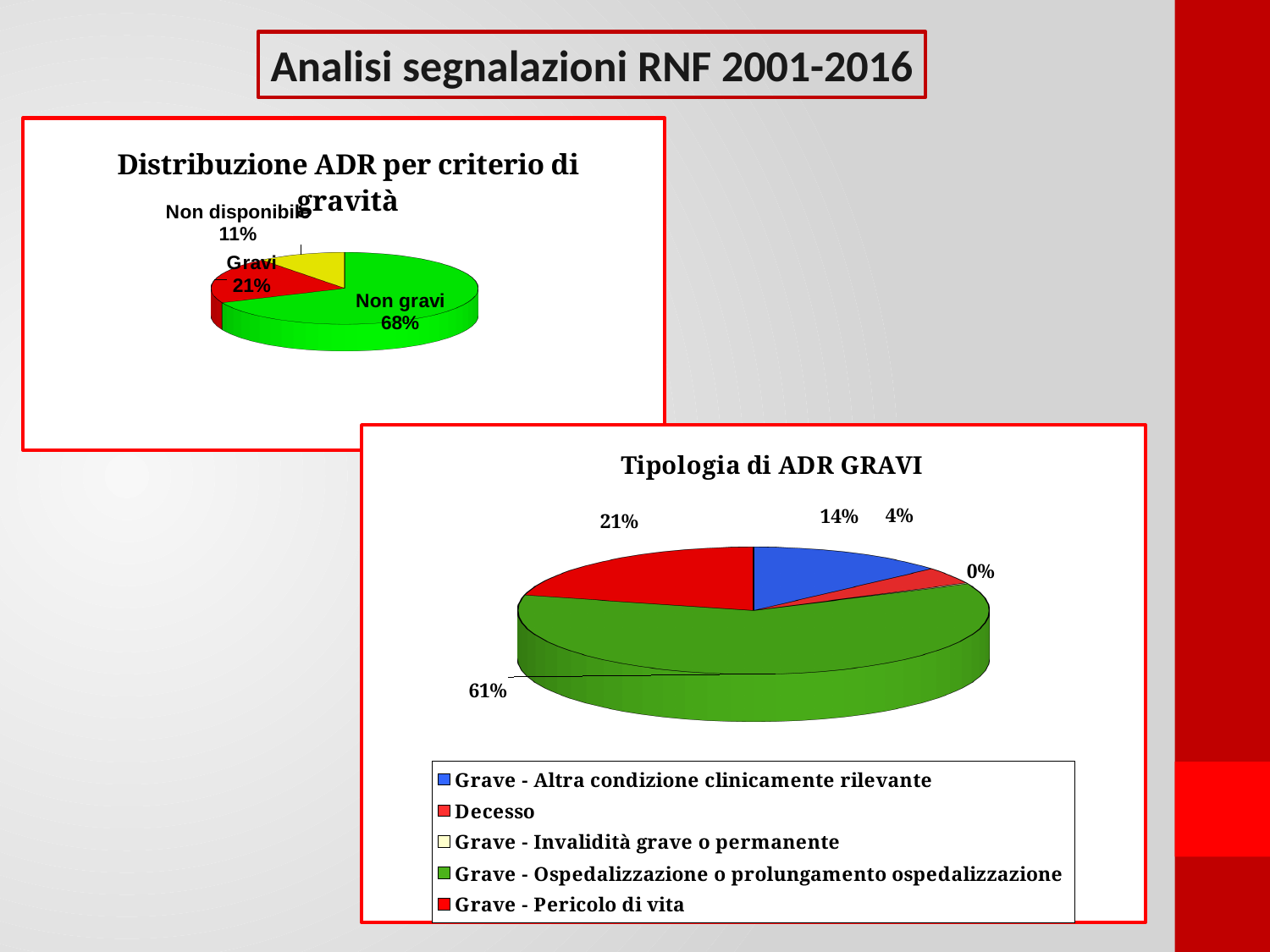
In the 'Tipologia di ADR GRAVI' chart, what share is labelled for Grave - Ospedalizzazione o prolungamento ospedalizzazione? 61% In the 'Distribuzione ADR per criterio di gravità' chart, what share is labelled for Non disponibile? 11% In the 'Distribuzione ADR per criterio di gravità' chart, which category has the smallest slice? Non disponibile In the 'Tipologia di ADR GRAVI' chart, what share is labelled for Grave - Altra condizione clinicamente rilevante? 14% In the 'Distribuzione ADR per criterio di gravità' chart, what share is labelled for Gravi? 21% In the 'Distribuzione ADR per criterio di gravità' chart, what share is labelled for Non gravi? 68% How many slices does the 'Distribuzione ADR per criterio di gravità' chart have? 3 How many entries does the legend of the 'Tipologia di ADR GRAVI' chart list? 5 What kind of chart is 'Tipologia di ADR GRAVI'? Pie chart In the 'Distribuzione ADR per criterio di gravità' chart, what is the difference in percentage points between Non gravi and Gravi? 47 In the 'Distribuzione ADR per criterio di gravità' chart, which category has the largest slice? Non gravi In the 'Tipologia di ADR GRAVI' chart, which category has the largest slice? Grave - Ospedalizzazione o prolungamento ospedalizzazione